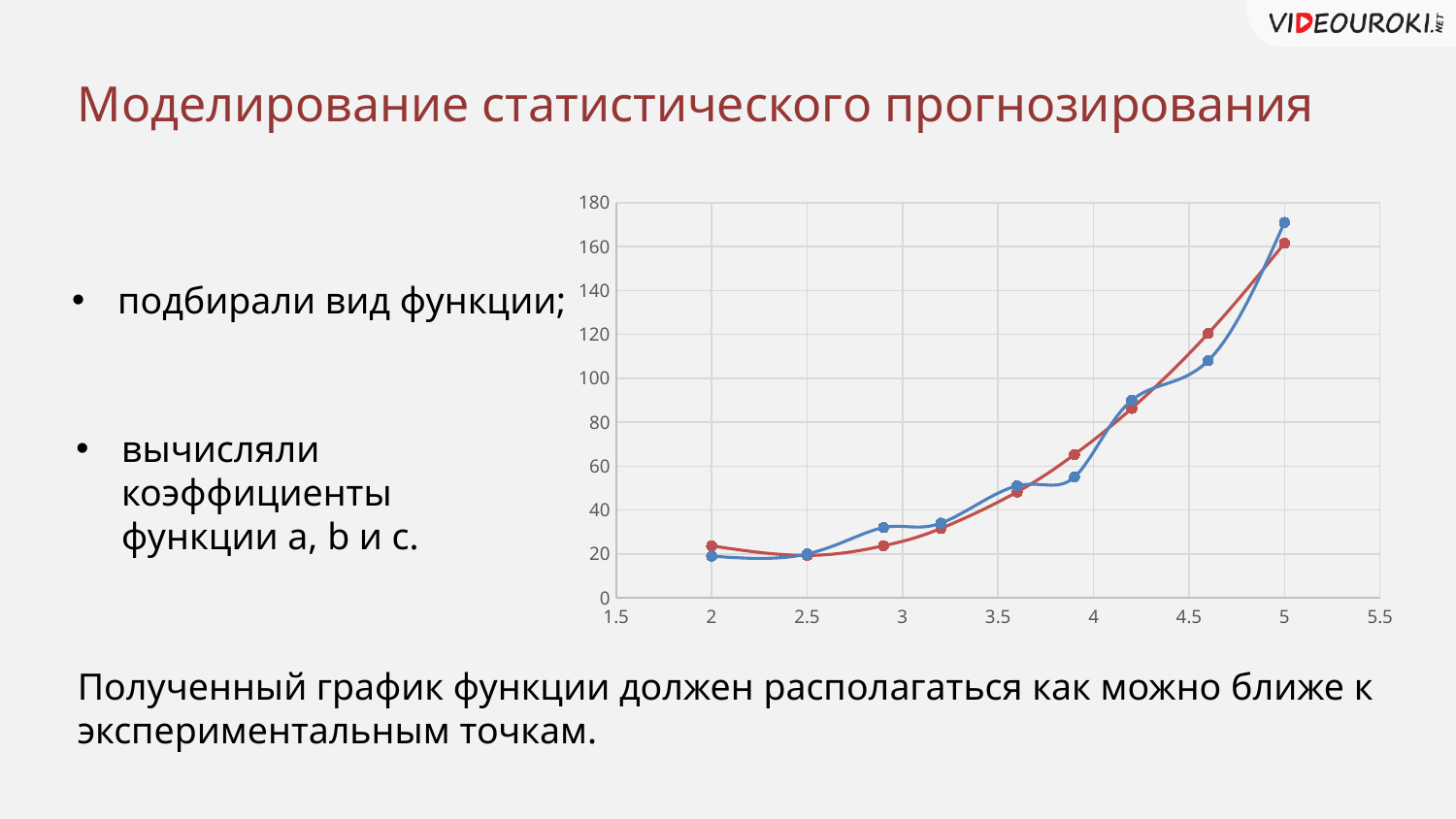
Is the value of the blue series at x = 4.6 greater or less than 100? greater Is the value of the blue series at x = 2.9 greater or less than 40? less At x = 4.6, which series has the higher value, blue or red? red What is the maximum value shown on the vertical axis? 180 What kind of chart is shown on the slide? line chart Is the value of the blue series at x = 5 greater or less than 160? greater At x = 5, which series has the higher value, blue or red? blue How many data points does the blue series have? 9 How many series are plotted on the chart? 2 At which x value does the blue series reach its highest point? 5 Do the values generally rise or fall as x increases from 2 to 5? rise